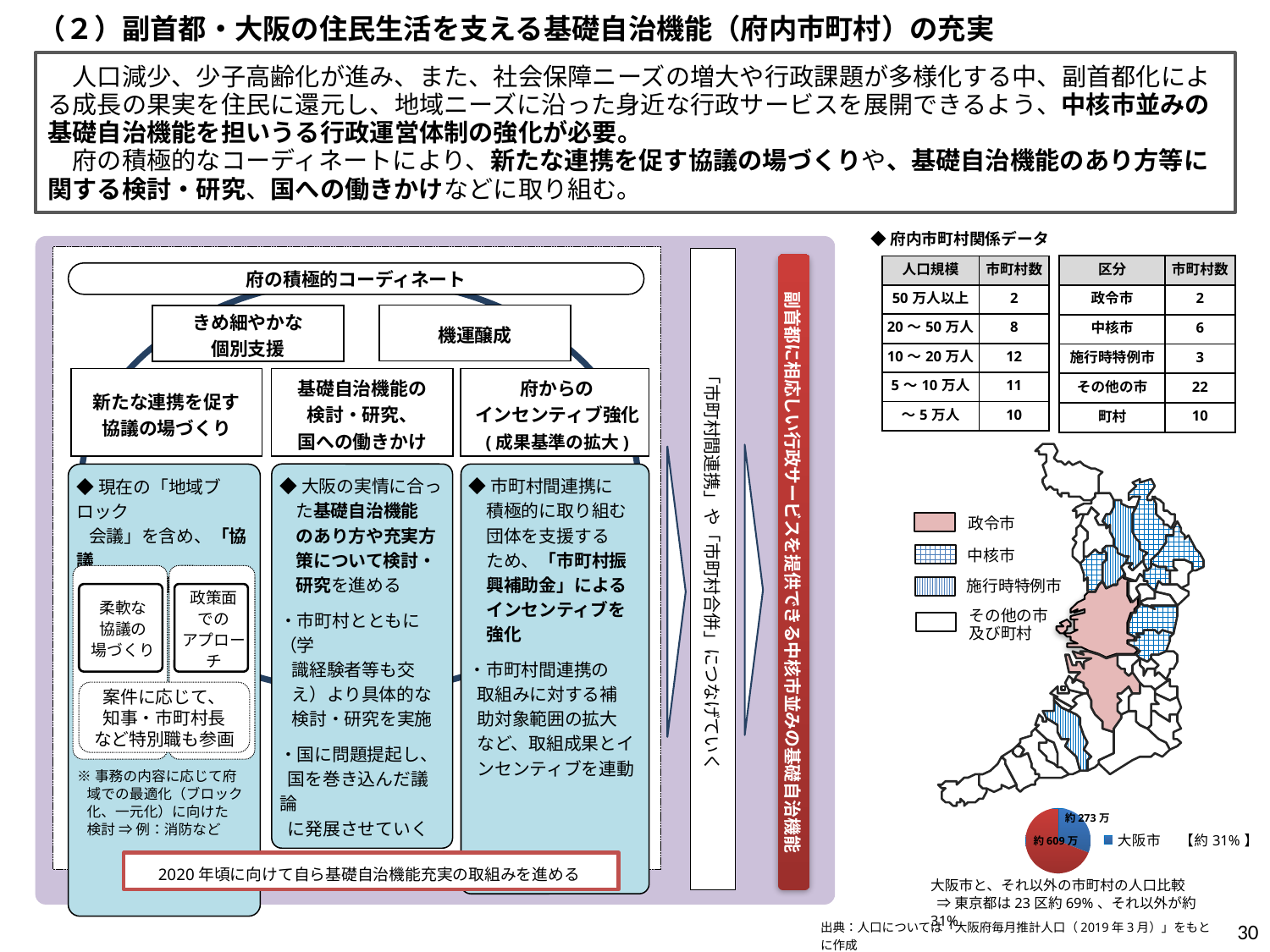
In the pie chart at the bottom right, which slice is larger: the 大阪市 slice (約273万) or the other slice (約609万)? the other slice (約609万) How many slices does the pie chart at the bottom right of the slide have? 2 In the pie chart at the bottom right, what value is labelled on the larger (red) slice? 約609万 What kind of chart is shown at the bottom right of the slide, below the map? pie chart How many entries does the legend of the pie chart at the bottom right list? 1 In the pie chart at the bottom right, what colour is the 大阪市 slice? blue According to the pie chart at the bottom right, what share of the total does 大阪市 account for? 約31% In the pie chart at the bottom right, what value is labelled on the 大阪市 slice? 約273万 What is the legend entry shown next to the pie chart at the bottom right? 大阪市 【約31%】 In the pie chart at the bottom right, which slice is the smallest? 大阪市